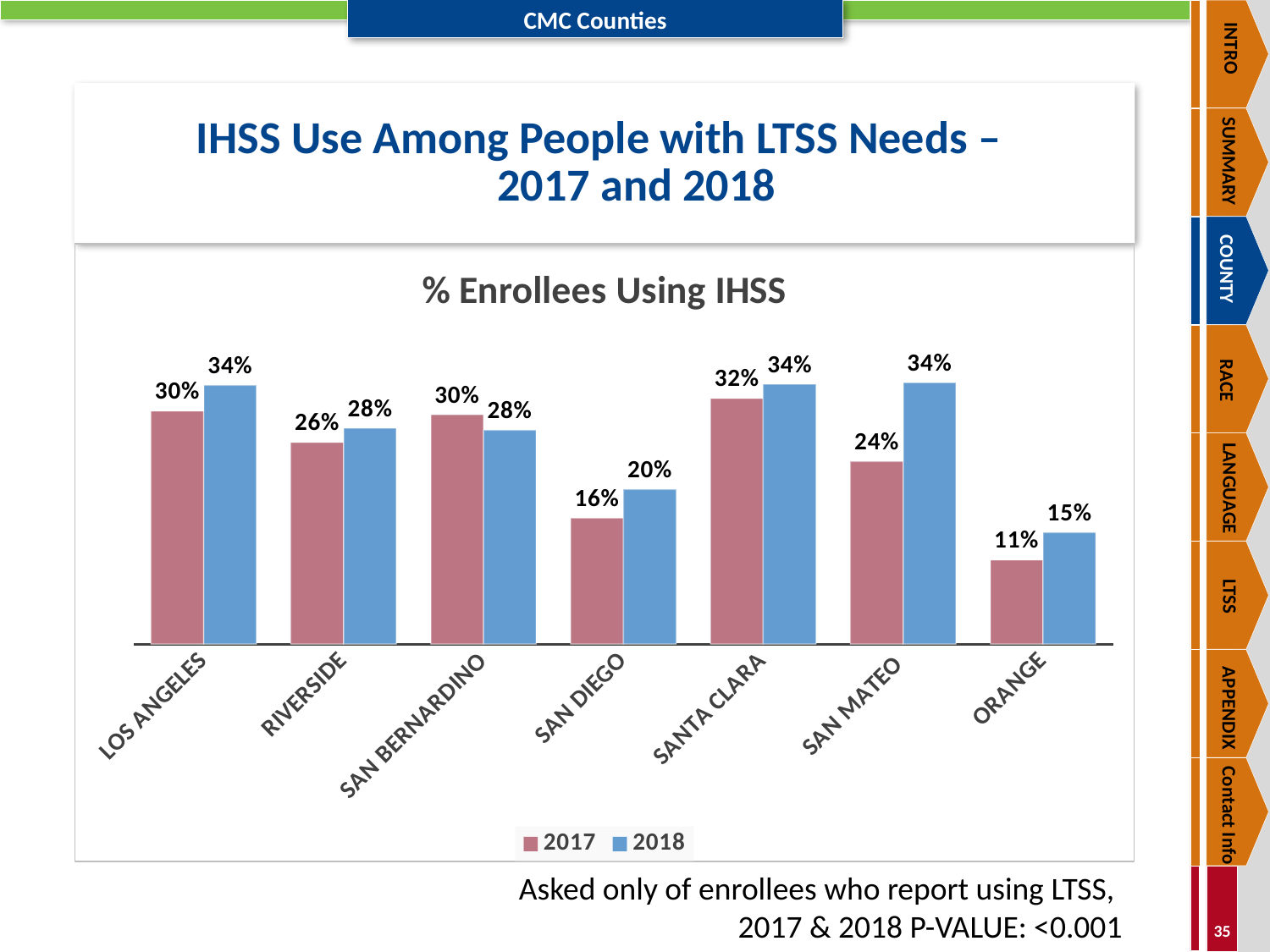
What is the title of the chart? % Enrollees Using IHSS What is the 2017 value for Riverside? 26% Which county has the highest 2017 value? Santa Clara What kind of chart is shown? Bar chart How many counties are shown on the x axis? 7 What is the difference between the 2017 values for Los Angeles and Orange? 19% For San Bernardino, which year has the larger value, 2017 or 2018? 2017 Which county has the lowest 2018 value? Orange How many series does the legend list? 2 What is the difference between the 2018 and 2017 values for San Mateo? 10% What is the 2018 value for San Mateo? 34% What is the 2017 value for San Diego? 16%